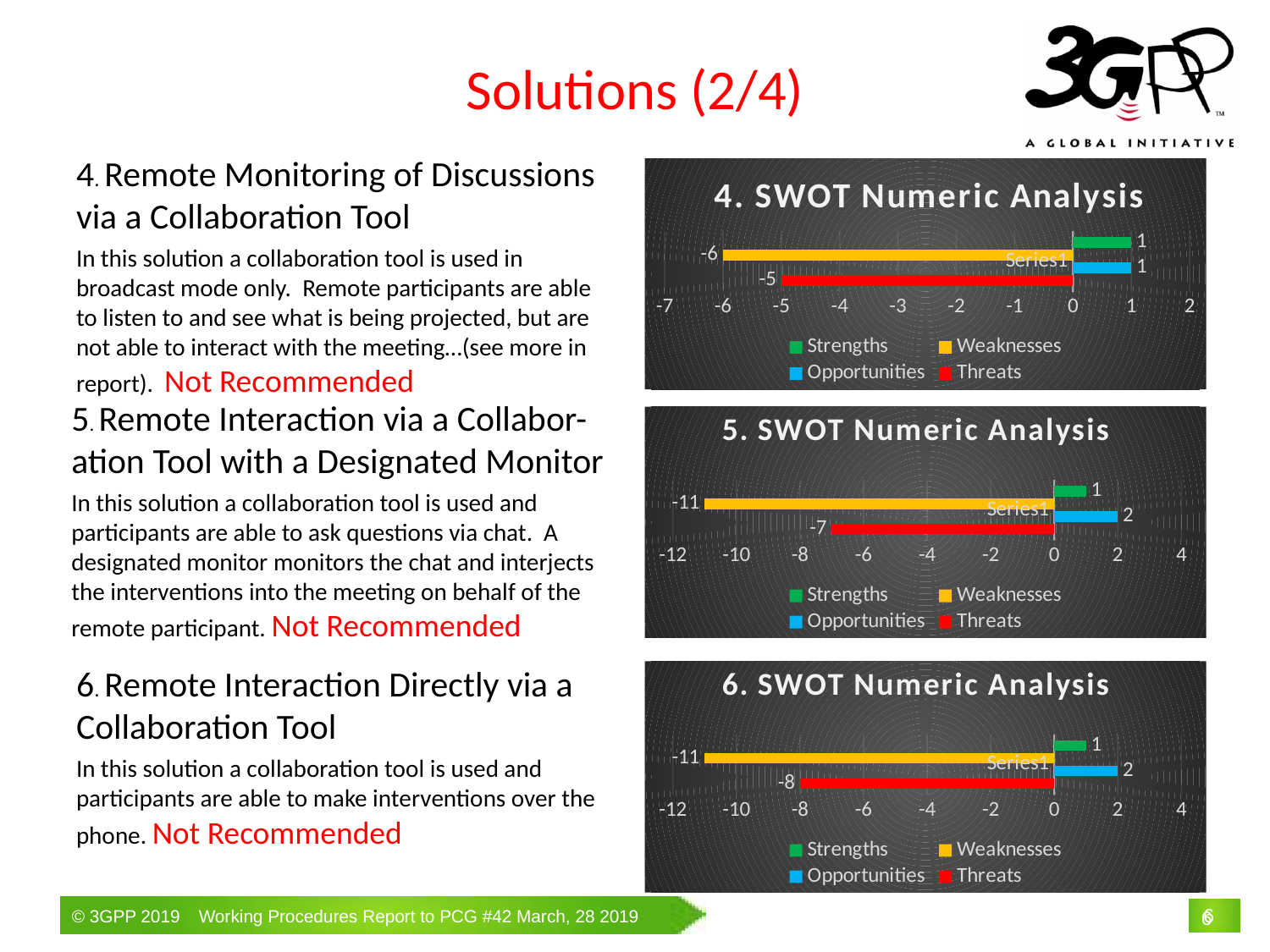
In the chart titled "5. SWOT Numeric Analysis", what is the value for Weaknesses? -11 In the chart titled "4. SWOT Numeric Analysis", what is the value for Weaknesses? -6 In the chart titled "5. SWOT Numeric Analysis", what is the value for Opportunities? 2 In the chart titled "4. SWOT Numeric Analysis", which series has the lowest value? Weaknesses In the chart titled "4. SWOT Numeric Analysis", what is the value for Threats? -5 In the chart titled "5. SWOT Numeric Analysis", is the Threats value larger or smaller than the Weaknesses value? larger In the chart titled "6. SWOT Numeric Analysis", what is the value for Strengths? 1 In the chart titled "5. SWOT Numeric Analysis", which series has the highest value? Opportunities What kind of chart is the chart titled "4. SWOT Numeric Analysis"? bar chart How many series does the legend list in the chart titled "6. SWOT Numeric Analysis"? 4 In the chart titled "6. SWOT Numeric Analysis", what is the difference between the Weaknesses value and the Threats value? 3 In the chart titled "6. SWOT Numeric Analysis", what is the value for Threats? -8